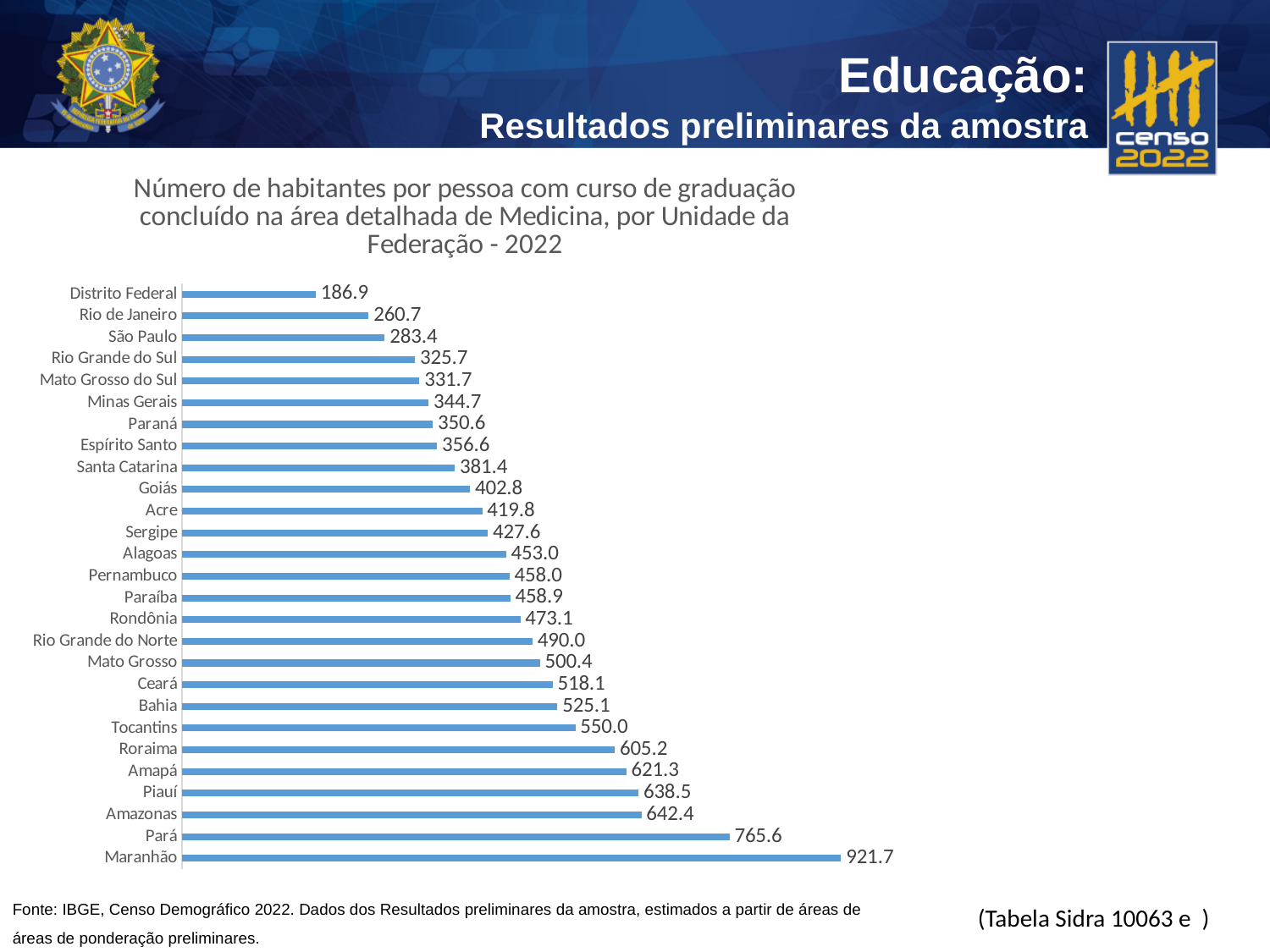
What is the difference between the values for Pará and Amazonas? 123.2 What kind of chart is shown on the slide? Bar chart Which has a larger value, Goiás or Santa Catarina? Goiás What is the difference between the values for Maranhão and Distrito Federal? 734.8 What is the value for Minas Gerais? 344.7 What is the value for Rio Grande do Norte? 490.0 Which state has the highest value? Maranhão What is the value for Pará? 765.6 Which has a larger value, Bahia or Ceará? Bahia How many units of the federation are shown in the chart? 27 What year does the chart title refer to? 2022 Which unit of the federation has the lowest value? Distrito Federal